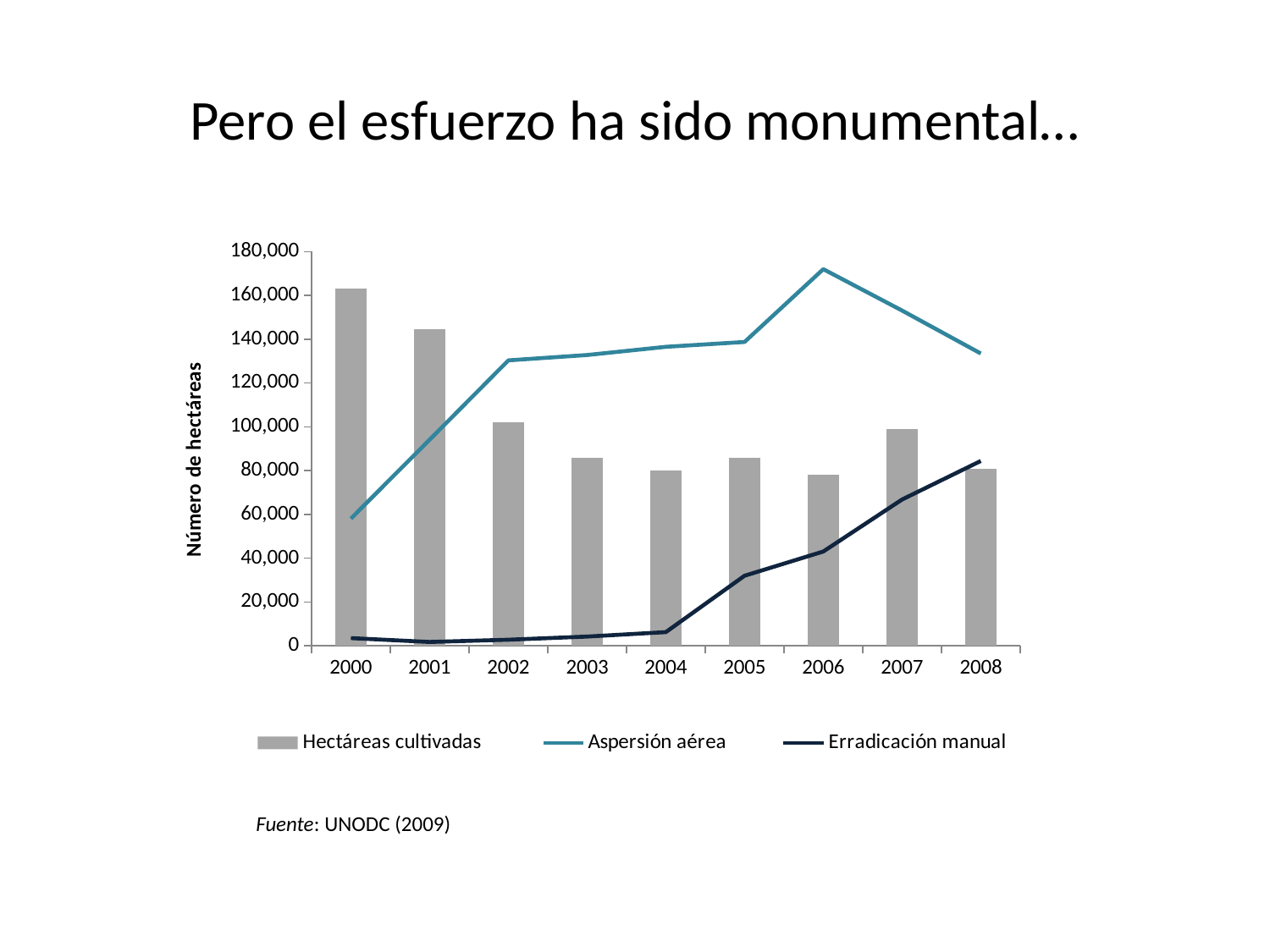
Is the value for Aspersión aérea in 2006 greater or less than 160,000? greater How many years are shown on the x axis? 9 Is the value for Aspersión aérea in 2000 greater or less than 80,000? less In which year does the Aspersión aérea line reach its highest value? 2006 Does the Erradicación manual line generally rise or fall from 2000 to 2008? rise In which year is the Hectáreas cultivadas bar highest? 2000 How many series does the legend list? 3 In 2000, which is larger: Hectáreas cultivadas or Aspersión aérea? Hectáreas cultivadas What kind of chart is shown on the slide? A combined bar and line chart Is the value for Erradicación manual in 2008 greater or less than 60,000? greater What is the label on the vertical axis? Número de hectáreas